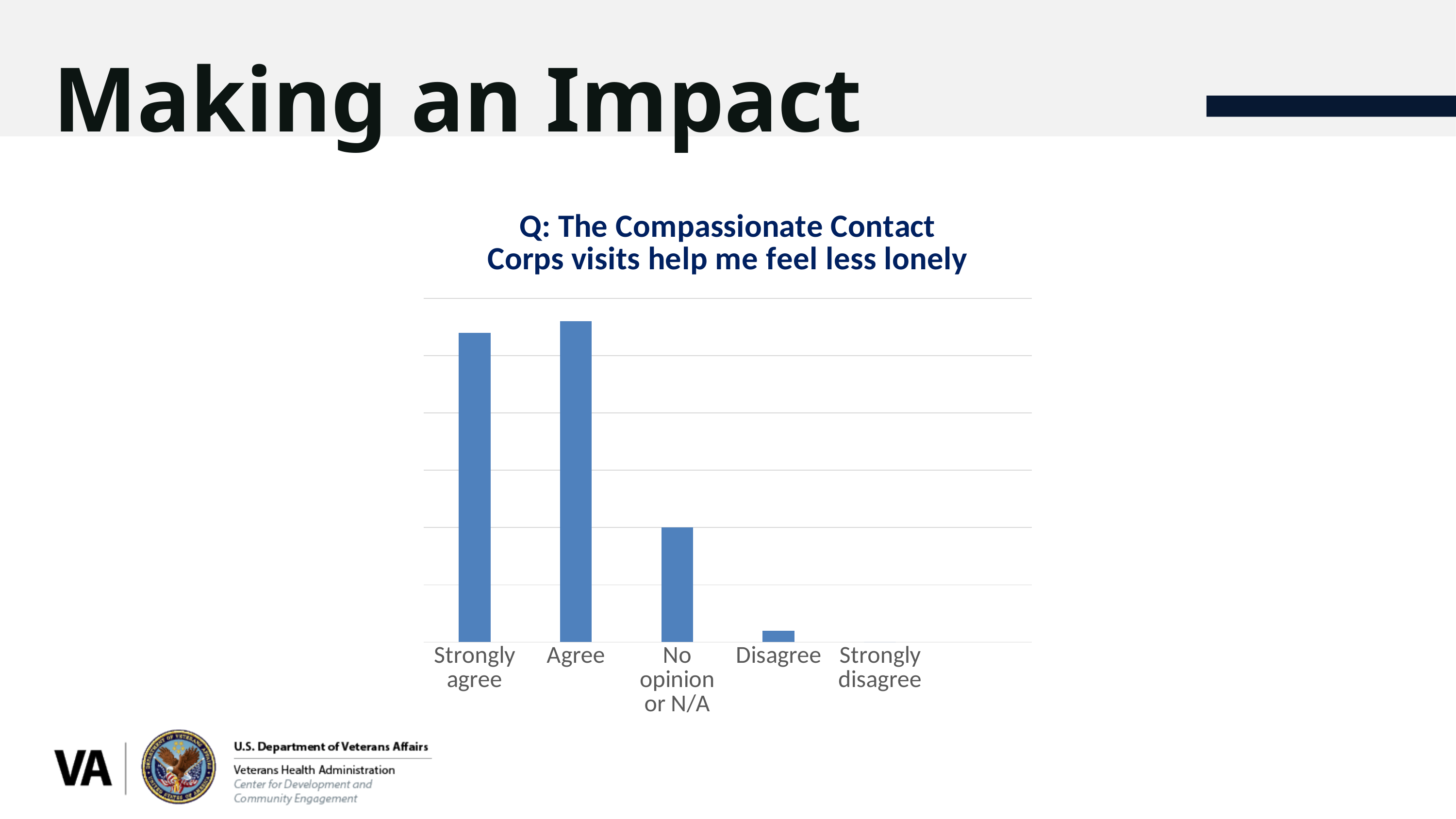
What kind of chart is shown on the slide? bar chart What colour are the bars in the chart? blue Which is larger, the value for Strongly agree or the value for No opinion or N/A? Strongly agree Which category is the second from the left on the x axis? Agree Which category has the tallest bar in the chart? Agree Which is larger, the value for Disagree or the value for Strongly disagree? Disagree How many categories are shown on the x axis of the chart? 5 What is the title of the chart? Q: The Compassionate Contact Corps visits help me feel less lonely Which is larger, the value for Agree or the value for Disagree? Agree Which category has the lowest value in the chart? Strongly disagree